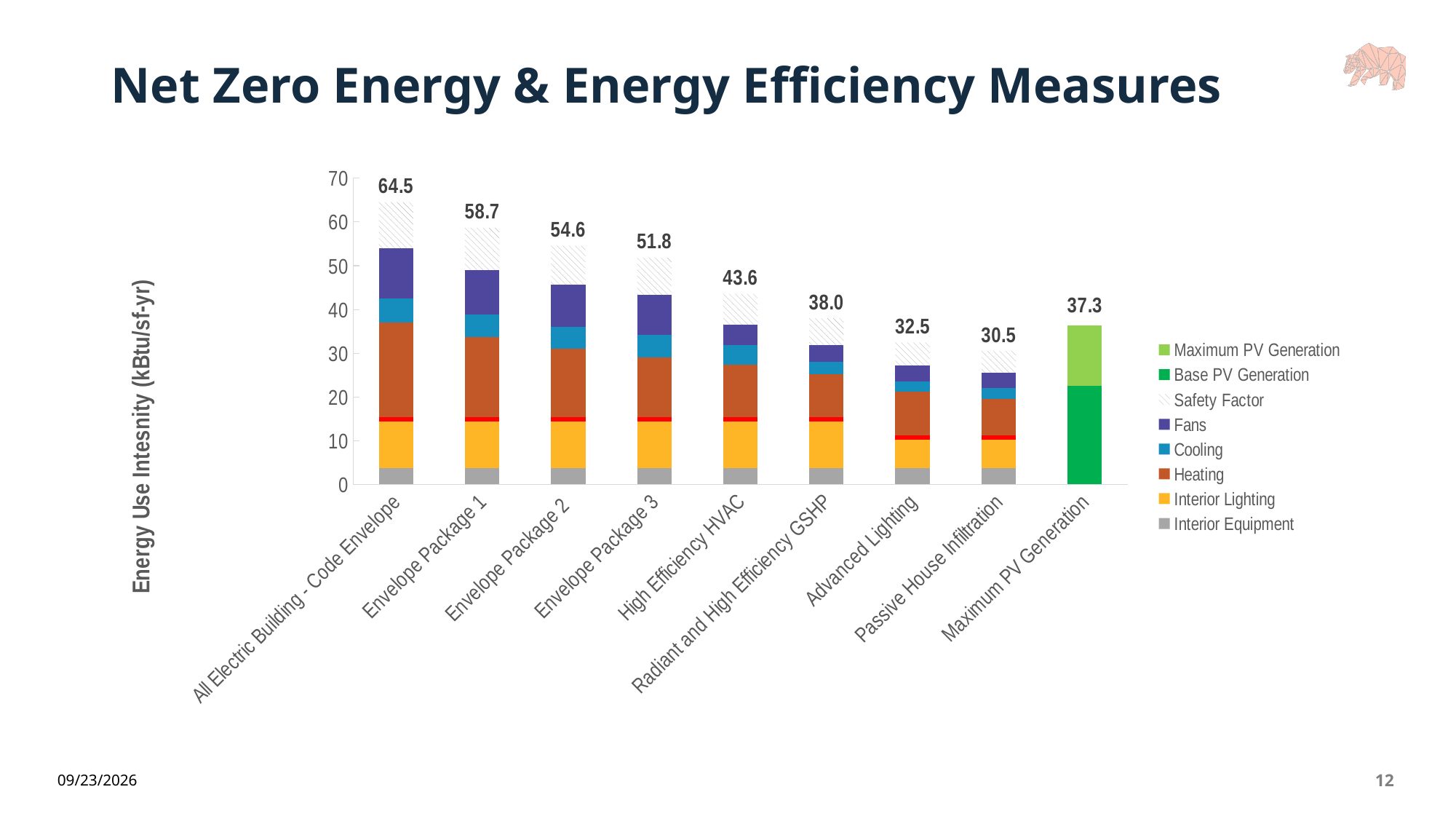
What is the difference between the labeled totals for All Electric Building - Code Envelope and Passive House Infiltration? 34.0 What kind of chart is shown on the slide? Stacked bar chart What is the total labeled value for the All Electric Building - Code Envelope bar? 64.5 Is the Base PV Generation segment of the Maximum PV Generation bar greater or less than 20? greater Which category has the lowest labeled total? Passive House Infiltration What is the total labeled value for the Envelope Package 2 bar? 54.6 What is the total labeled value for the Maximum PV Generation bar? 37.3 How many series does the legend list? 8 How many categories are shown on the x axis? 9 Which has a larger labeled total, High Efficiency HVAC or Radiant and High Efficiency GSHP? High Efficiency HVAC What is the difference between the labeled totals for Envelope Package 1 and Envelope Package 2? 4.1 Which category has the highest labeled total? All Electric Building - Code Envelope